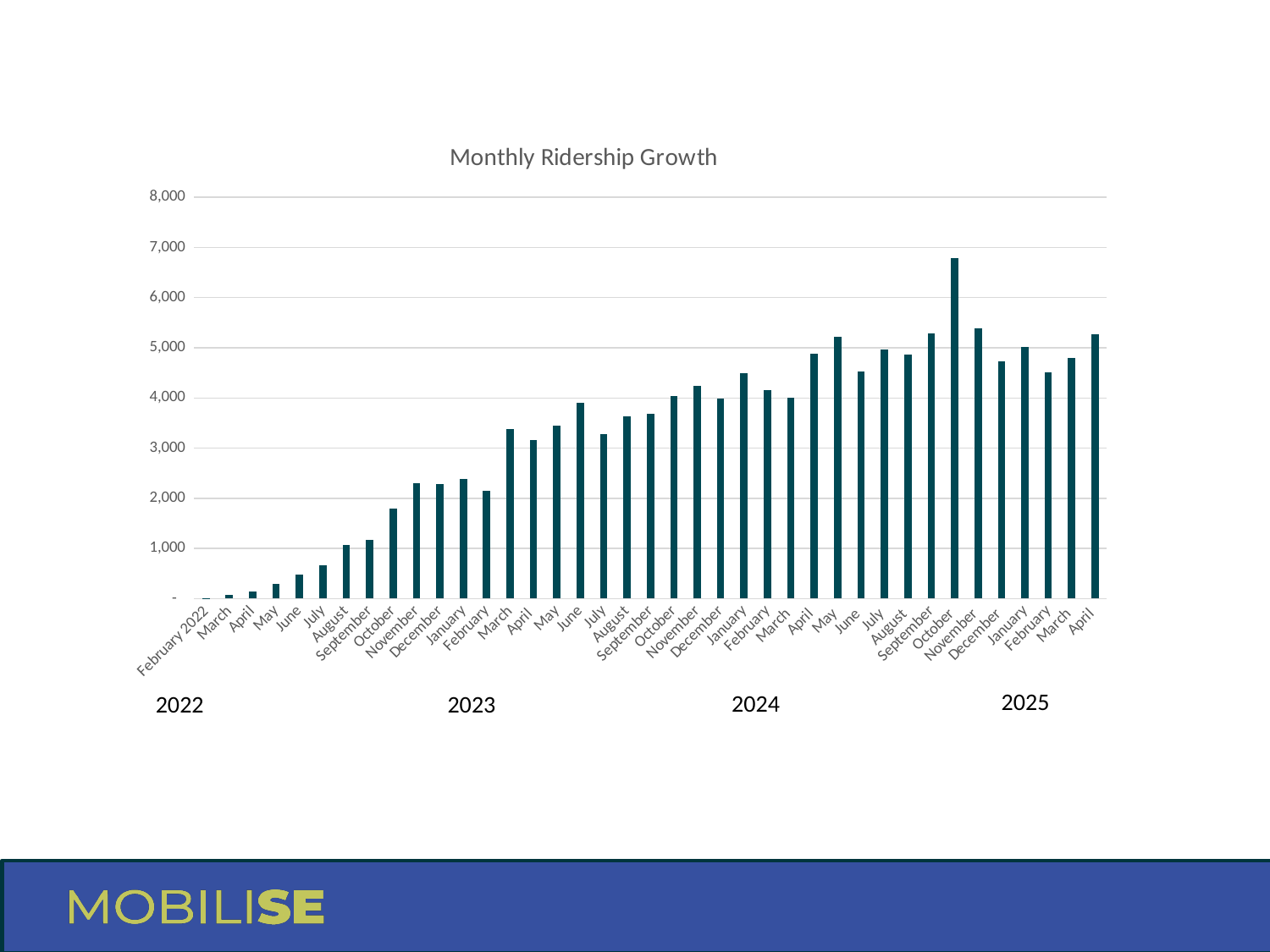
Is the value for July 2022 greater or less than 1,000? less Overall, do the ridership values rise or fall from February 2022 to April 2025? Rise Which years are labelled beneath the x axis of the chart? 2022, 2023, 2024, 2025 What is the title of the chart? Monthly Ridership Growth Which month has the lowest ridership in the chart? February 2022 Is the value for March 2023 greater or less than 3,000? greater Is the value for October 2024 greater or less than 6,000? greater Which month has the highest ridership in the chart? October 2024 Which is larger, the value for June 2023 or the value for July 2023? June 2023 What kind of chart is shown on the slide? Bar chart